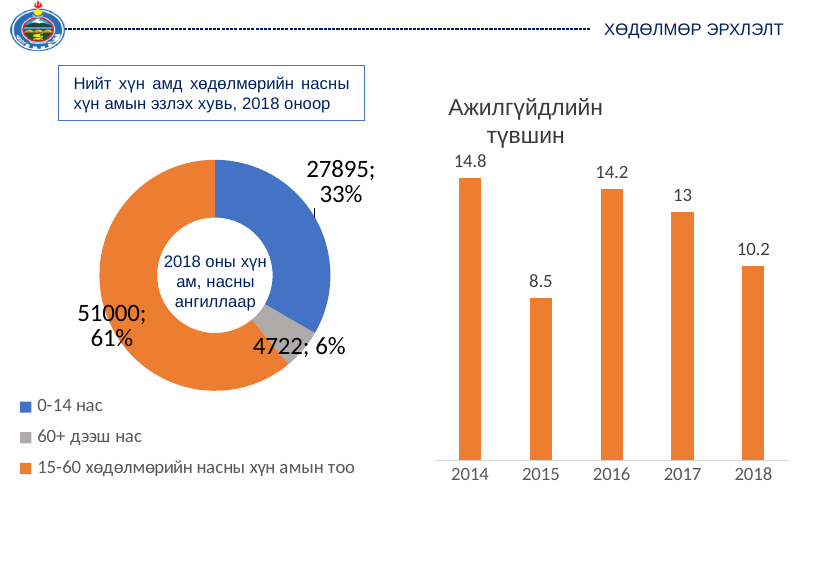
In the bar chart titled 'Ажилгүйдлийн түвшин', what is the value for 2014? 14.8 What kind of chart is the chart titled 'Ажилгүйдлийн түвшин'? bar chart In the doughnut chart on the left, which category has the largest share? 15-60 хөдөлмөрийн насны хүн амын тоо In the doughnut chart on the left, what share of the total does '60+ дээш нас' represent? 6% In the bar chart titled 'Ажилгүйдлийн түвшин', what is the difference between the values for 2016 and 2015? 5.7 In the bar chart titled 'Ажилгүйдлийн түвшин', which year has the lowest value? 2015 In the bar chart titled 'Ажилгүйдлийн түвшин', which year has the highest value? 2014 In the bar chart titled 'Ажилгүйдлийн түвшин', which is larger, the value for 2017 or the value for 2018? 2017 In the bar chart titled 'Ажилгүйдлийн түвшин', what is the value for 2018? 10.2 In the doughnut chart on the left, what value and share are shown for '0-14 нас'? 27895; 33% How many years are shown on the x axis of the bar chart titled 'Ажилгүйдлийн түвшин'? 5 How many categories does the legend of the doughnut chart on the left list? 3